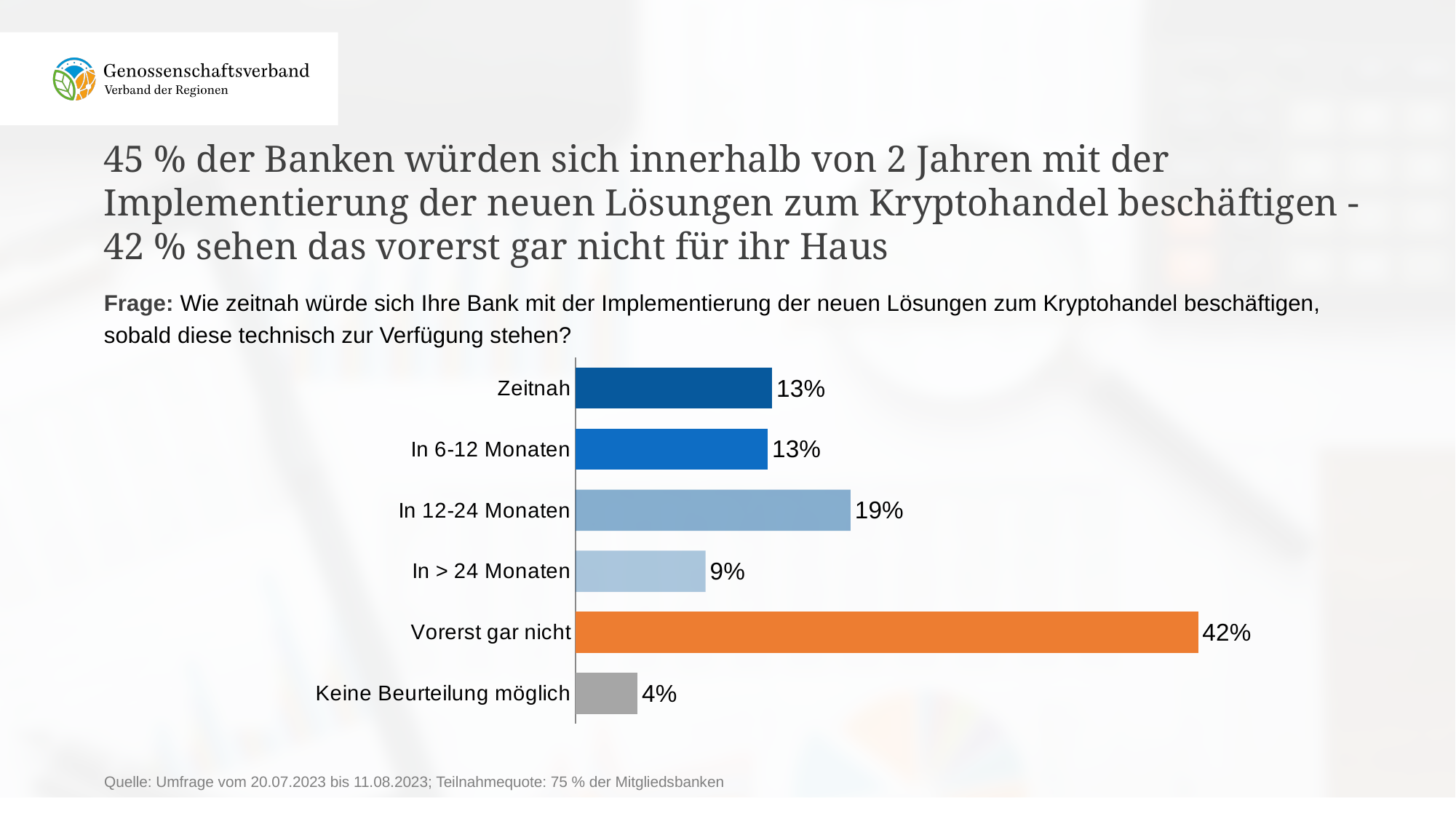
Which category has the highest value? Vorerst gar nicht What is the value for "Vorerst gar nicht"? 42% Which category has the lowest value? Keine Beurteilung möglich Which is larger, the value for "In 12-24 Monaten" or the value for "Zeitnah"? In 12-24 Monaten What is the difference between the values for "Vorerst gar nicht" and "In 12-24 Monaten"? 23% What is the value for "Keine Beurteilung möglich"? 4% What is the value for "In 12-24 Monaten"? 19% What colour is the bar for "Vorerst gar nicht"? Orange What kind of chart is shown on the slide? Bar chart How many categories are shown in the chart? 6 What is the value for "In > 24 Monaten"? 9% What is the difference between the values for "In 12-24 Monaten" and "In > 24 Monaten"? 10%